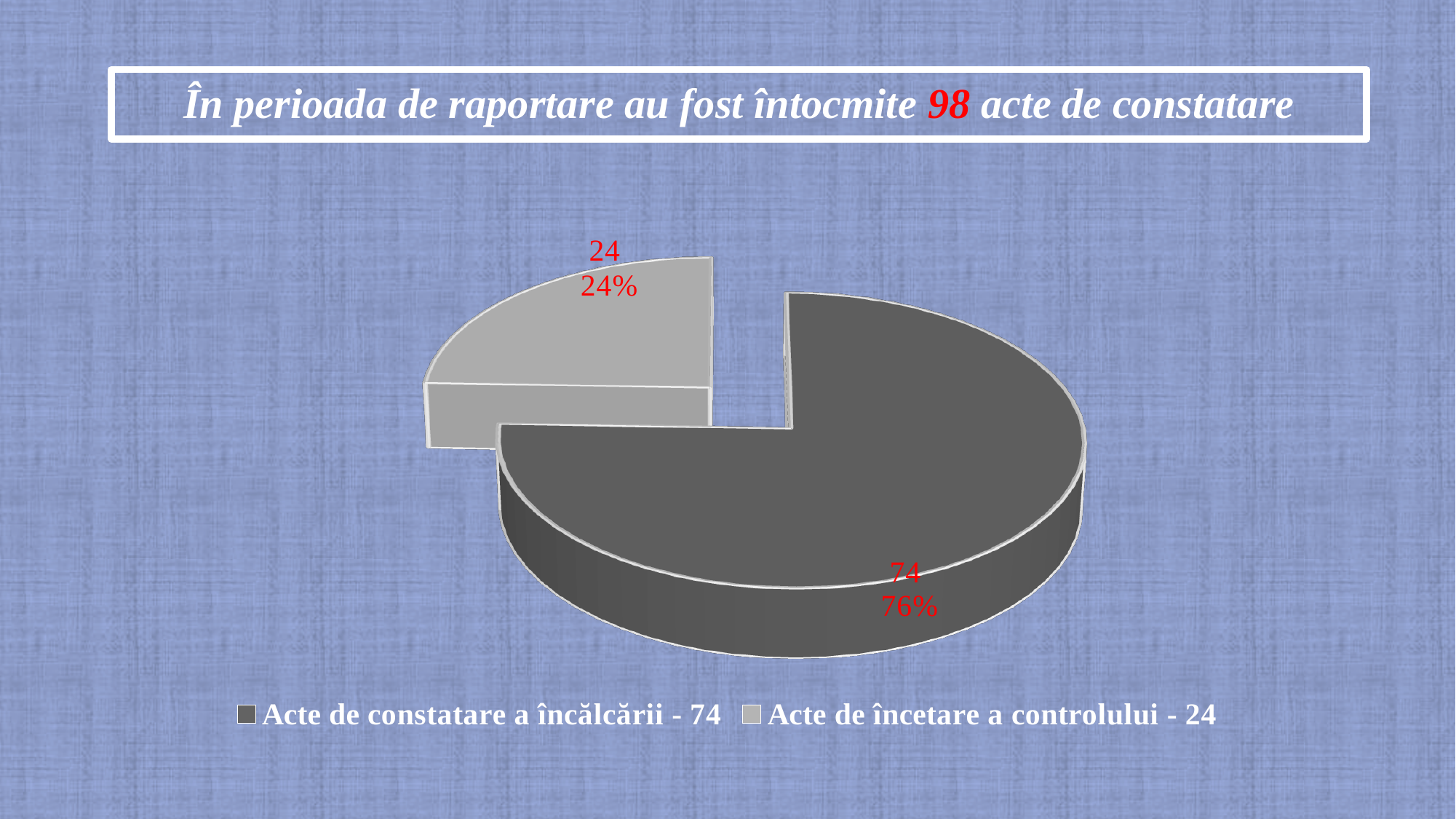
Which category has the smallest slice? Acte de încetare a controlului What share of the pie does "Acte de constatare a încălcării" represent? 76% What is the difference between the values for "Acte de constatare a încălcării" and "Acte de încetare a controlului"? 50 What is the value for "Acte de încetare a controlului"? 24 What share of the pie does "Acte de încetare a controlului" represent? 24% Which category has the largest slice? Acte de constatare a încălcării Which is larger: "Acte de constatare a încălcării" or "Acte de încetare a controlului"? Acte de constatare a încălcării What is the total of the two slices in the pie chart? 98 What is the value for "Acte de constatare a încălcării"? 74 What colour is the slice for "Acte de încetare a controlului"? light grey How many slices does the pie chart have? 2 What kind of chart is shown on the slide? pie chart